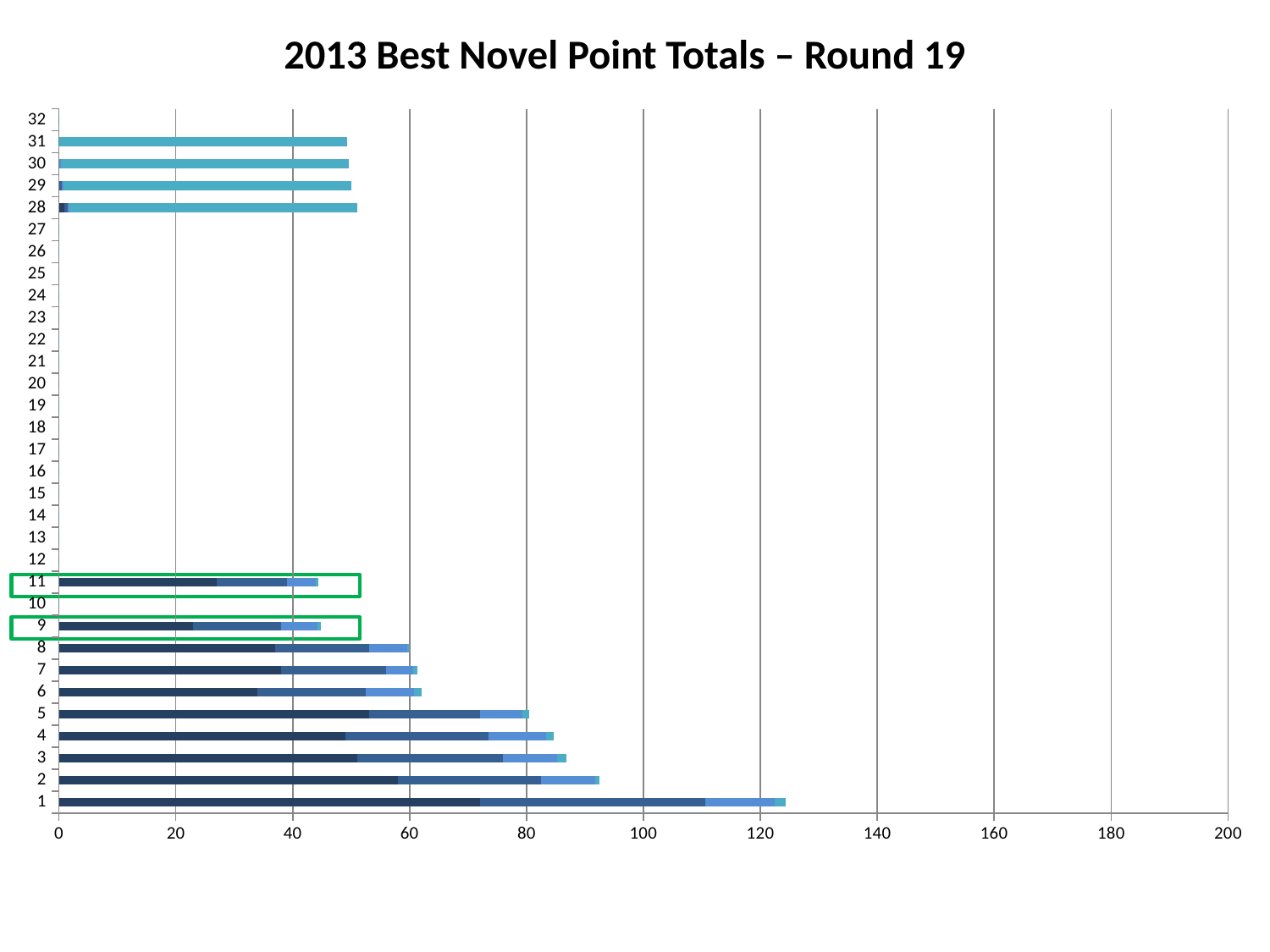
Is the total value for category 1 greater or less than 100? greater Which has the larger total, category 28 or category 11? 28 Which has the larger total, category 2 or category 5? 2 What is the title of the chart? 2013 Best Novel Point Totals – Round 19 Is the total value for category 2 greater or less than 100? less Which category has the longest bar in the chart? 1 Is the total value for category 3 greater or less than 80? greater What kind of chart is shown on the slide? bar chart Which two categories are highlighted with green boxes on the chart? 9 and 11 How many categories are listed on the vertical axis of the chart? 32